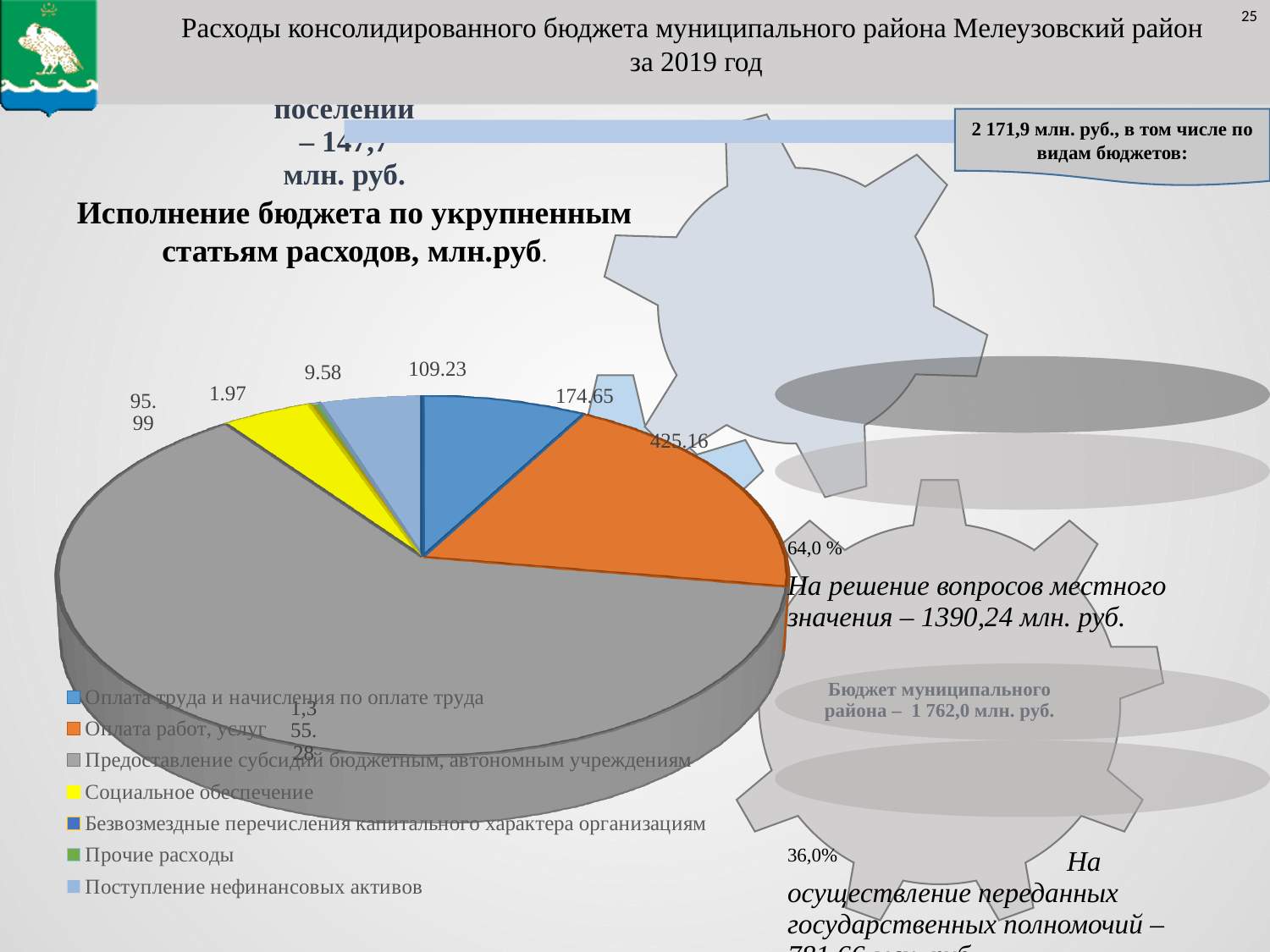
Which is larger, Оплата труда и начисления по оплате труда or Социальное обеспечение? Оплата труда и начисления по оплате труда Which category has the largest slice of the pie? Предоставление субсидий бюджетным, автономным учреждениям How many entries does the chart legend list? 7 Which is smaller, Прочие расходы or Социальное обеспечение? Прочие расходы What is the difference between the values for Оплата труда и начисления по оплате труда and Социальное обеспечение? 78.66 What is the value for Социальное обеспечение? 95.99 What is the value for Оплата труда и начисления по оплате труда? 174.65 What colour is the slice for Социальное обеспечение? yellow What is the title of the chart on the slide? Исполнение бюджета по укрупненным статьям расходов, млн.руб. What is the value for Прочие расходы? 9.58 What kind of chart is shown on the slide? pie chart